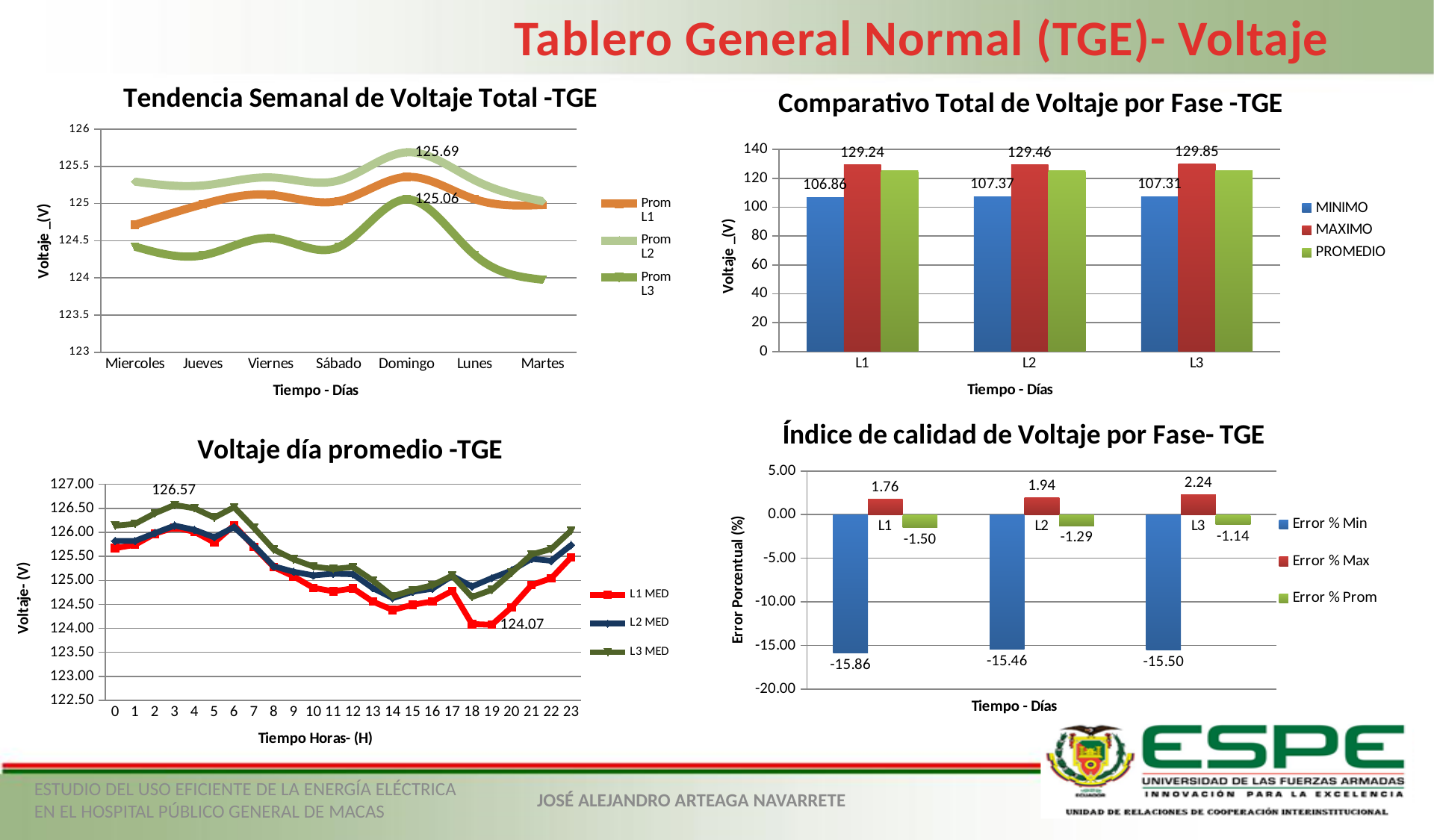
In the chart 'Índice de calidad de Voltaje por Fase- TGE', what is the Error % Min value for L1? -15.86 In the chart 'Comparativo Total de Voltaje por Fase -TGE', what is the difference between the MAXIMO and MINIMO values for L3? 22.54 How many hourly points are plotted along the x axis of the chart 'Voltaje día promedio -TGE'? 24 What kind of chart is 'Tendencia Semanal de Voltaje Total -TGE'? line chart In the chart 'Comparativo Total de Voltaje por Fase -TGE', what is the MINIMO value for L1? 106.86 In the chart 'Tendencia Semanal de Voltaje Total -TGE', what is the labelled value for Prom L2 on Domingo? 125.69 In the chart 'Comparativo Total de Voltaje por Fase -TGE', which phase has the highest MAXIMO value? L3 How many series does the legend of the chart 'Índice de calidad de Voltaje por Fase- TGE' list? 3 In the chart 'Índice de calidad de Voltaje por Fase- TGE', what is the Error % Max value for L3? 2.24 In the chart 'Comparativo Total de Voltaje por Fase -TGE', is the PROMEDIO value for L1 greater or less than 120? greater In the chart 'Índice de calidad de Voltaje por Fase- TGE', which phase has the lowest Error % Min value? L1 In the chart 'Comparativo Total de Voltaje por Fase -TGE', what is the MAXIMO value for L3? 129.85